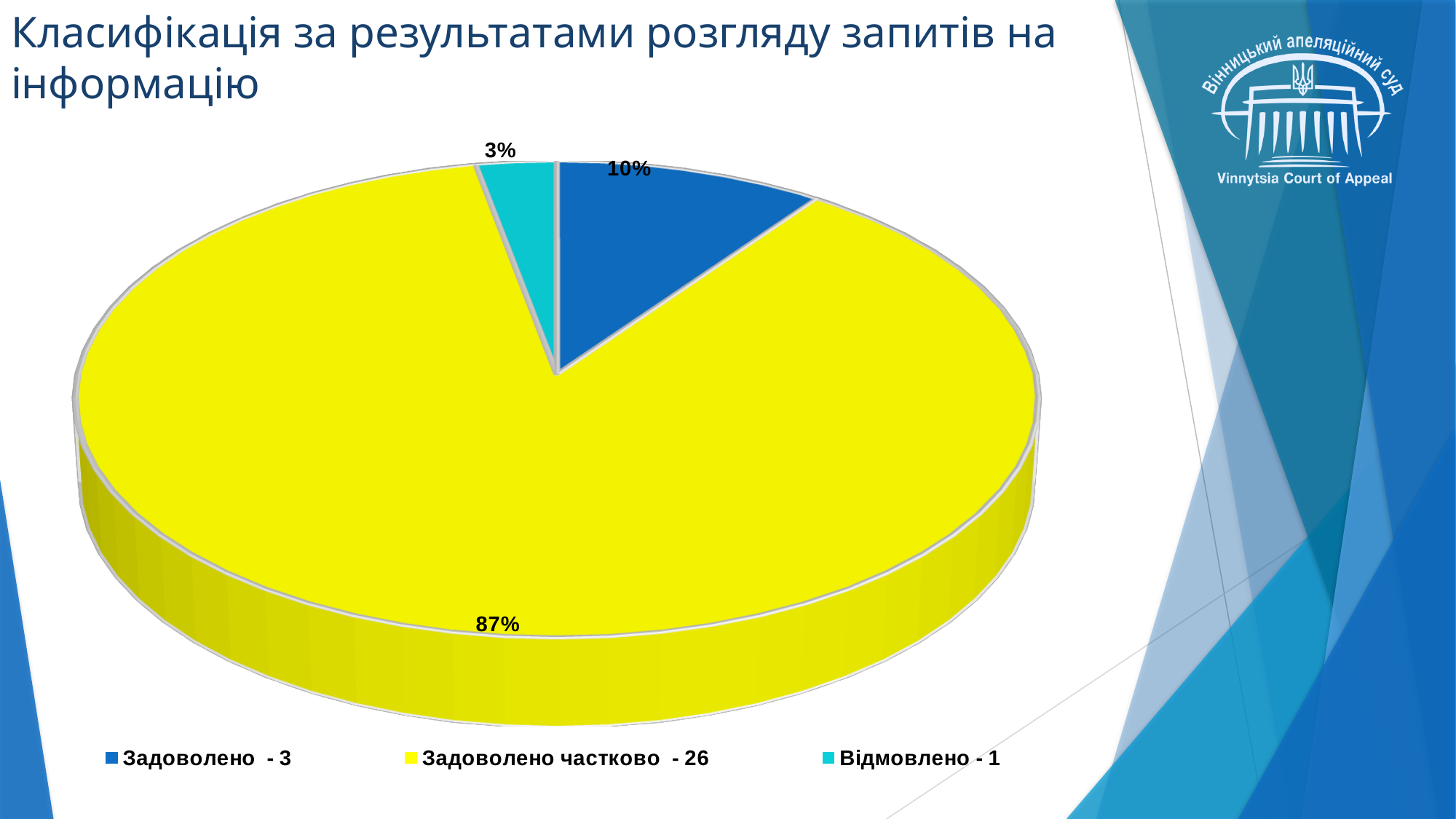
What is the difference in percentage points between the 'Задоволено частково - 26' slice and the 'Задоволено - 3' slice? 77% What percentage share does the 'Задоволено - 3' slice have? 10% What kind of chart is shown on the slide? Pie chart Which category has the largest slice of the pie? Задоволено частково - 26 What percentage share does the 'Задоволено частково - 26' slice have? 87% What is the title of the slide containing the chart? Класифікація за результатами розгляду запитів на інформацію What colour is the 'Задоволено частково - 26' slice? Yellow How many categories does the pie chart show? 3 What percentage share does the 'Відмовлено - 1' slice have? 3% Which is larger: the share for 'Задоволено - 3' or the share for 'Відмовлено - 1'? Задоволено - 3 What is the difference in percentage points between the 'Задоволено - 3' slice and the 'Відмовлено - 1' slice? 7% Which category has the smallest slice of the pie? Відмовлено - 1